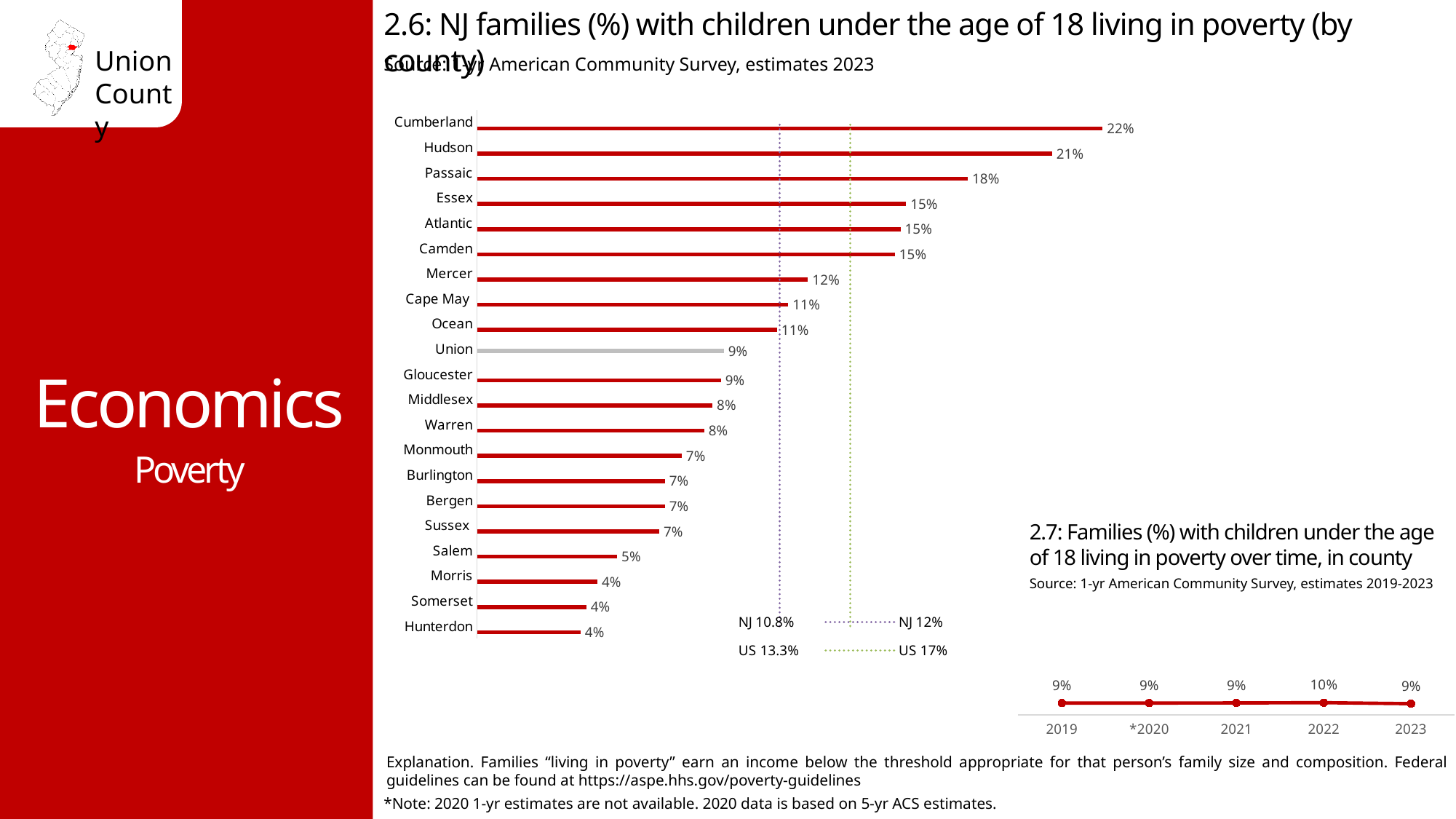
In chart 2.6 (by county), what is the value for Salem? 5% In chart 2.6 (by county), how many counties are plotted? 21 In chart 2.6 (NJ families with children under 18 living in poverty by county), what is the value for Cumberland? 22% In chart 2.6 (by county), what is the value for Union? 9% In chart 2.7 (families in poverty over time, in county), what is the value for 2022? 10% What kind of chart is chart 2.7 (over time, in county)? Line chart In chart 2.7 (over time, in county), how many years are plotted? 5 In chart 2.6 (by county), what is the difference between Hudson and Passaic? 3% What kind of chart is chart 2.6 (by county)? Bar chart In chart 2.6 (by county), which county has the highest value? Cumberland In chart 2.6 (by county), which is larger, the value for Mercer or the value for Cape May? Mercer